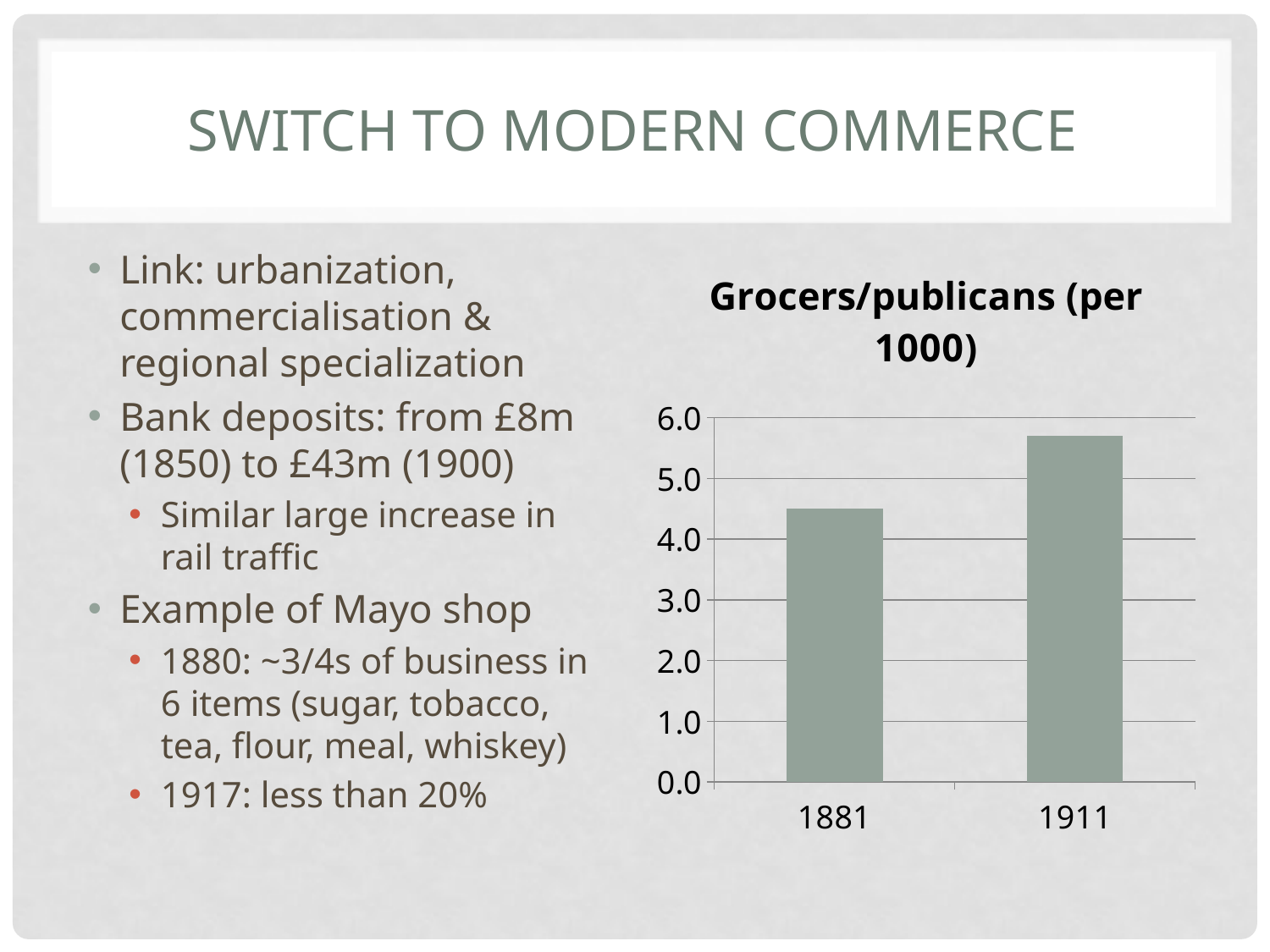
What kind of chart is shown on the slide? bar chart Do the values rise or fall from 1881 to 1911? rise Which year has the highest value in the chart? 1911 What is the highest value shown on the y axis of the chart? 6.0 Is the value for 1911 greater or less than 5.0? greater Which is larger, the value for 1881 or the value for 1911? 1911 What is the title of the chart? Grocers/publicans (per 1000) Is the value for 1881 greater or less than 5.0? less Is the value for 1911 greater or less than 6.0? less Which year has the lowest value in the chart? 1881 How many categories are shown on the x axis of the chart? 2